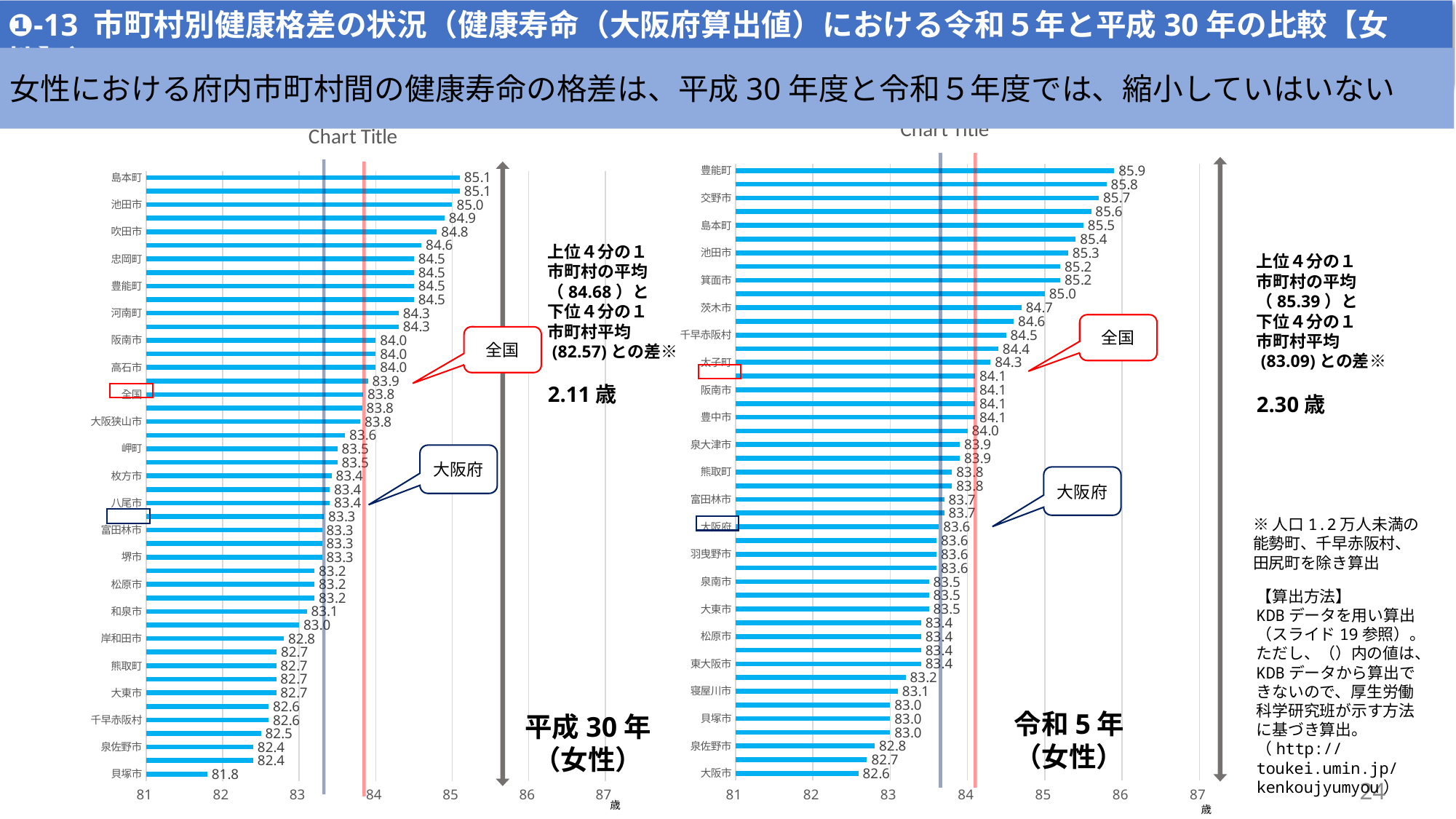
In the 平成30年（女性） chart, which category has the lowest value? 貝塚市 What type of chart is used on the left (平成30年（女性）) side of the slide? bar chart In the 平成30年（女性） chart, what is the value for 島本町? 85.1 According to the annotation next to the 令和5年（女性） chart, what is the gap between the top-quarter and bottom-quarter municipality averages? 2.30歳 In the 令和5年（女性） chart, is the value for 大阪府 greater or less than 84? less In the 平成30年（女性） chart, what is the difference between 島本町 (85.1) and 貝塚市 (81.8)? 3.3 In the 平成30年（女性） chart, which is larger, the value for 吹田市 or the value for 岸和田市? 吹田市 In the 令和5年（女性） chart, what is the value for 交野市? 85.7 In the 令和5年（女性） chart, what is the difference between 豊能町 (85.9) and 大阪市 (82.6)? 3.3 In the 平成30年（女性） chart, what is the value for 吹田市? 84.8 In the 令和5年（女性） chart, which category has the highest value? 豊能町 In the 令和5年（女性） chart, which category has the lowest value? 大阪市